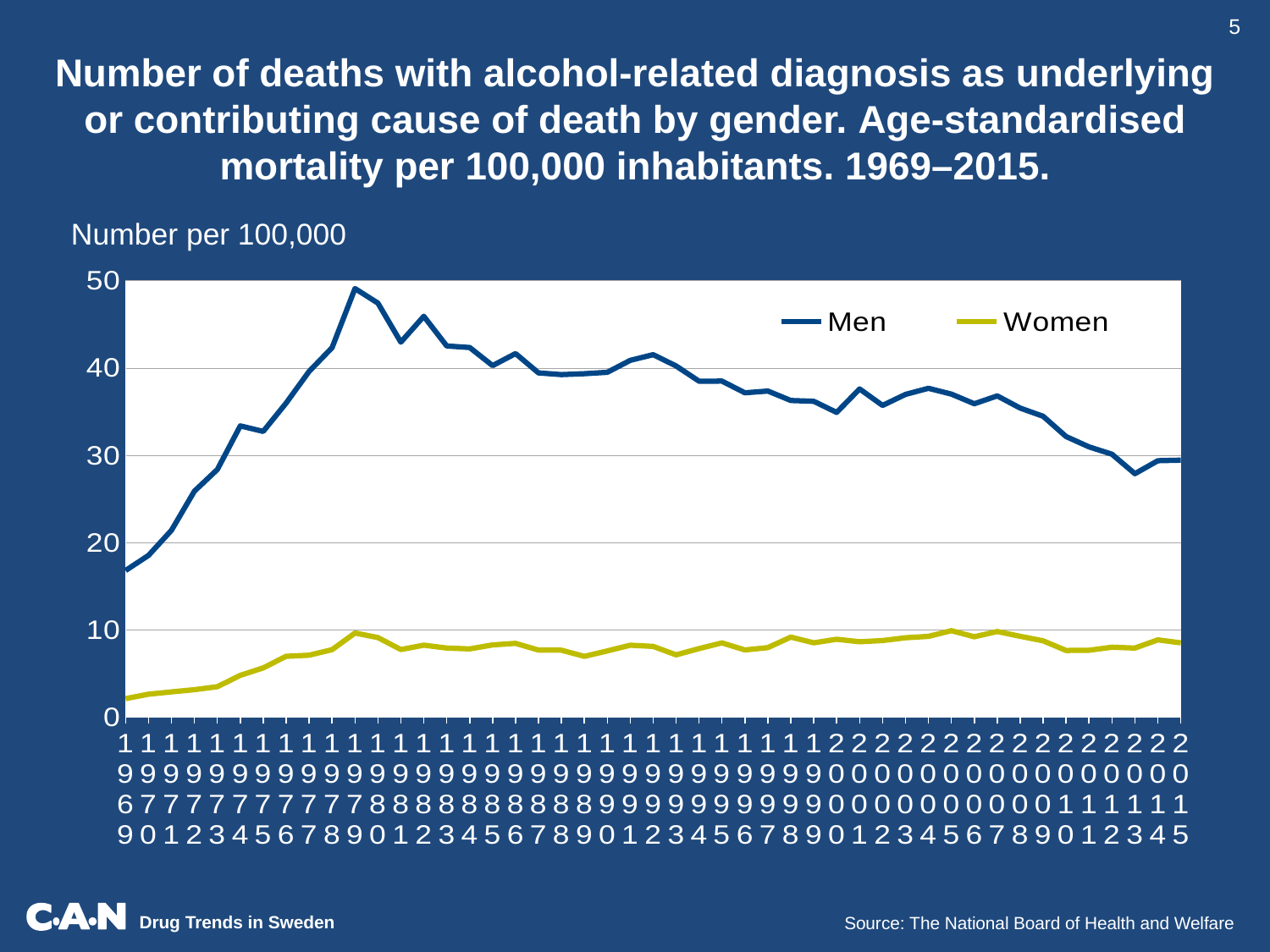
Which two series are shown in the legend? Men and Women How many series does the legend list? 2 What kind of chart is shown on the slide? Line chart What is the label shown above the y axis? Number per 100,000 Does the Men series rise or fall between 1969 and 1979? Rise Is the value for Men in 1969 greater or less than 20? less How many years are plotted along the x axis? 47 Is the value for Men in 1979 greater or less than 40? greater In which year does the Men series reach its highest value? 1979 Is the value for Women in 1969 greater or less than 10? less Which series has the higher value in 1990, Men or Women? Men